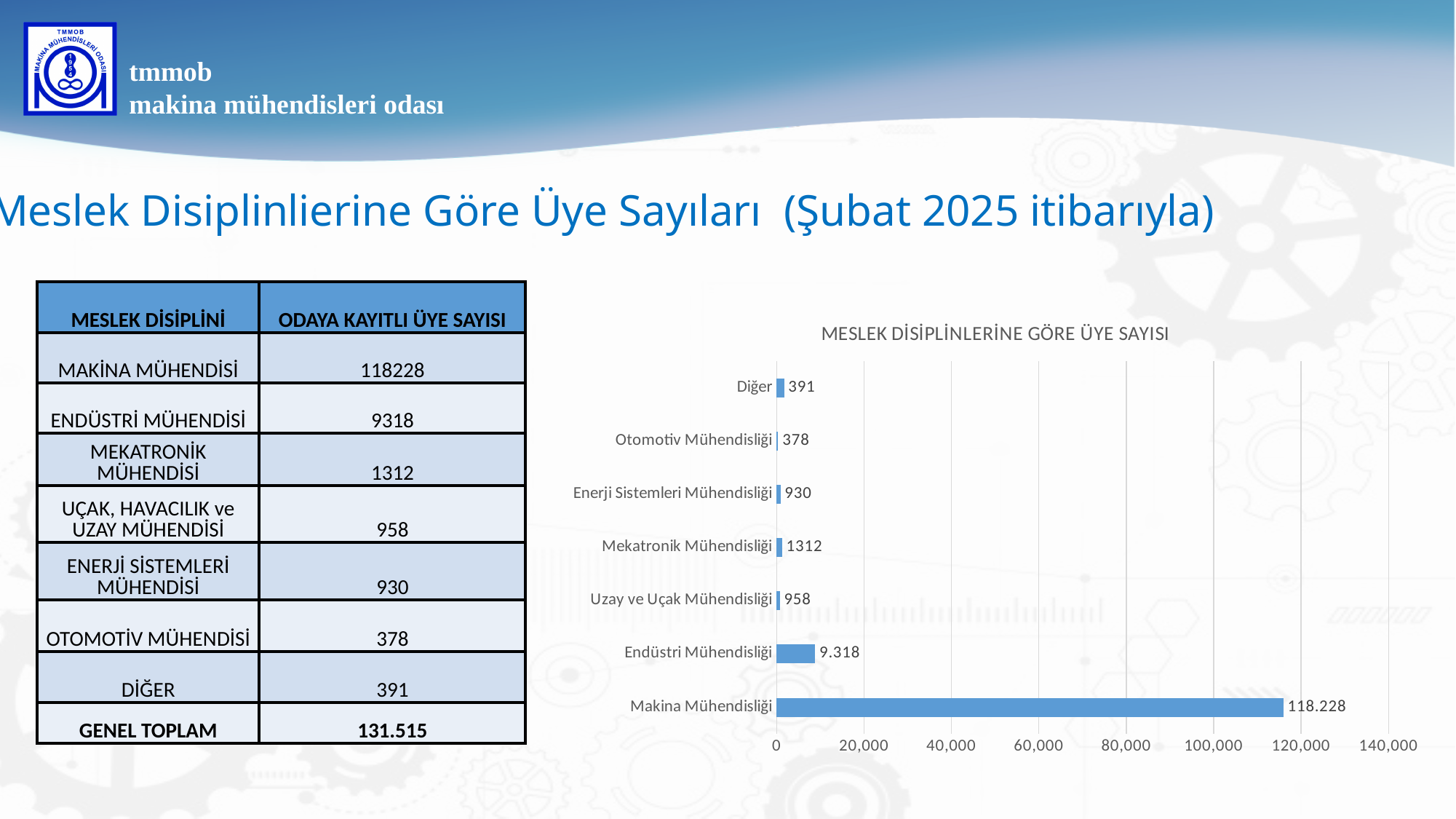
What kind of chart is shown on the slide? Bar chart Which category has the lowest value in the chart? Otomotiv Mühendisliği What is the title of the chart? MESLEK DİSİPLİNLERİNE GÖRE ÜYE SAYISI Which is larger, the value for Diğer or the value for Otomotiv Mühendisliği? Diğer What is the value shown for Mekatronik Mühendisliği in the chart? 1312 What is the difference between the values for Mekatronik Mühendisliği and Uzay ve Uçak Mühendisliği? 354 How many categories are shown in the chart? 7 Which category has the highest value in the chart? Makina Mühendisliği What is the value shown for Makina Mühendisliği in the chart? 118.228 Is the value for Makina Mühendisliği greater or less than 100,000? greater What is the value shown for Endüstri Mühendisliği in the chart? 9.318 What is the value shown for Otomotiv Mühendisliği in the chart? 378